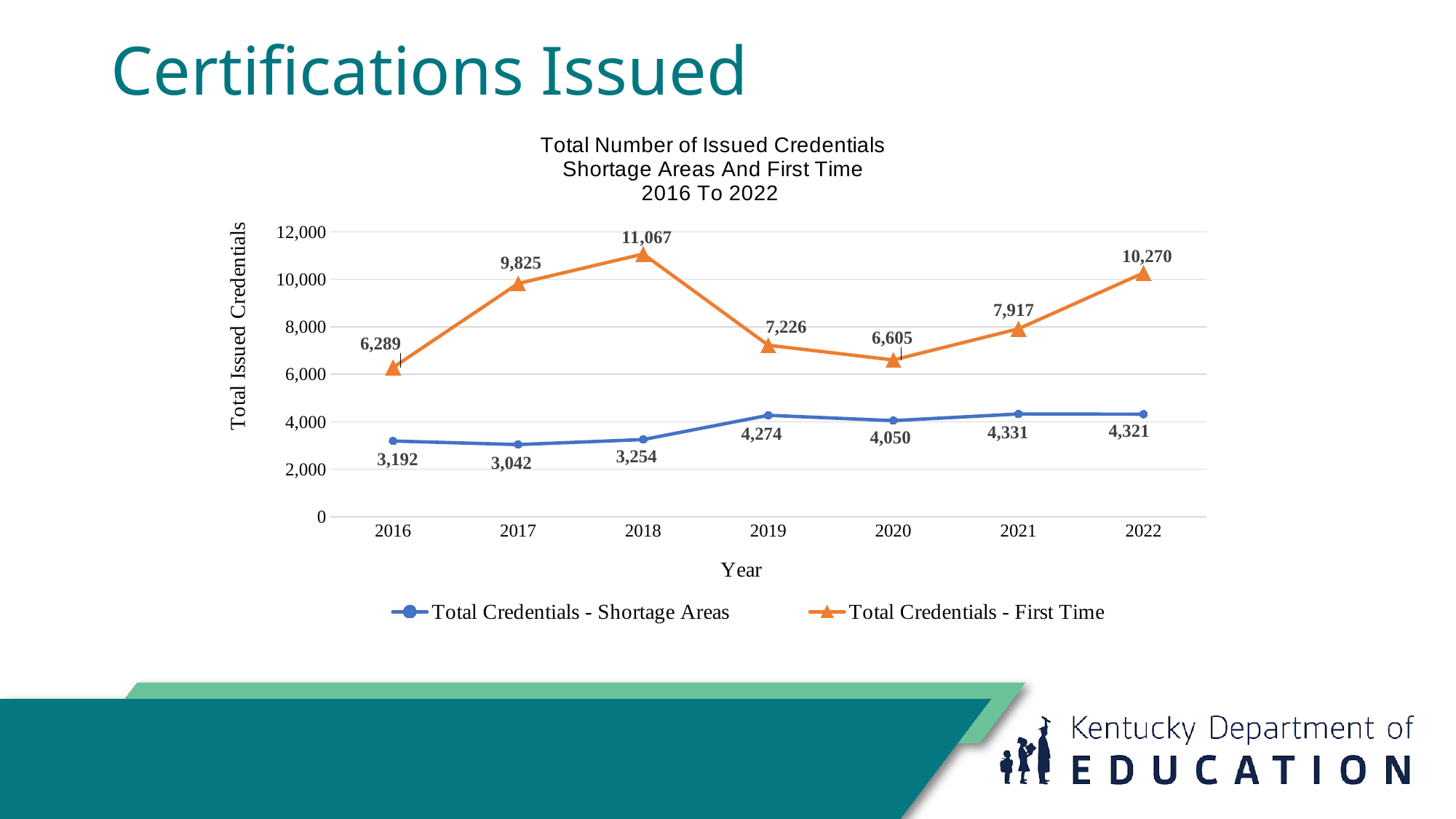
What was the value for Total Credentials - Shortage Areas in 2020? 4,050 In which year was Total Credentials - Shortage Areas lowest? 2017 How many series does the legend list? 2 What is the difference between Total Credentials - First Time and Total Credentials - Shortage Areas in 2022? 5,949 What kind of chart is shown on the slide? line chart How many years are shown on the x axis? 7 What is the label of the y axis? Total Issued Credentials In which year was Total Credentials - First Time highest? 2018 Is the value for Total Credentials - First Time in 2020 greater or less than 8,000? less Which was larger in 2019: Total Credentials - First Time or Total Credentials - Shortage Areas? Total Credentials - First Time What was the value for Total Credentials - First Time in 2018? 11,067 Did Total Credentials - First Time rise or fall from 2018 to 2019? fall